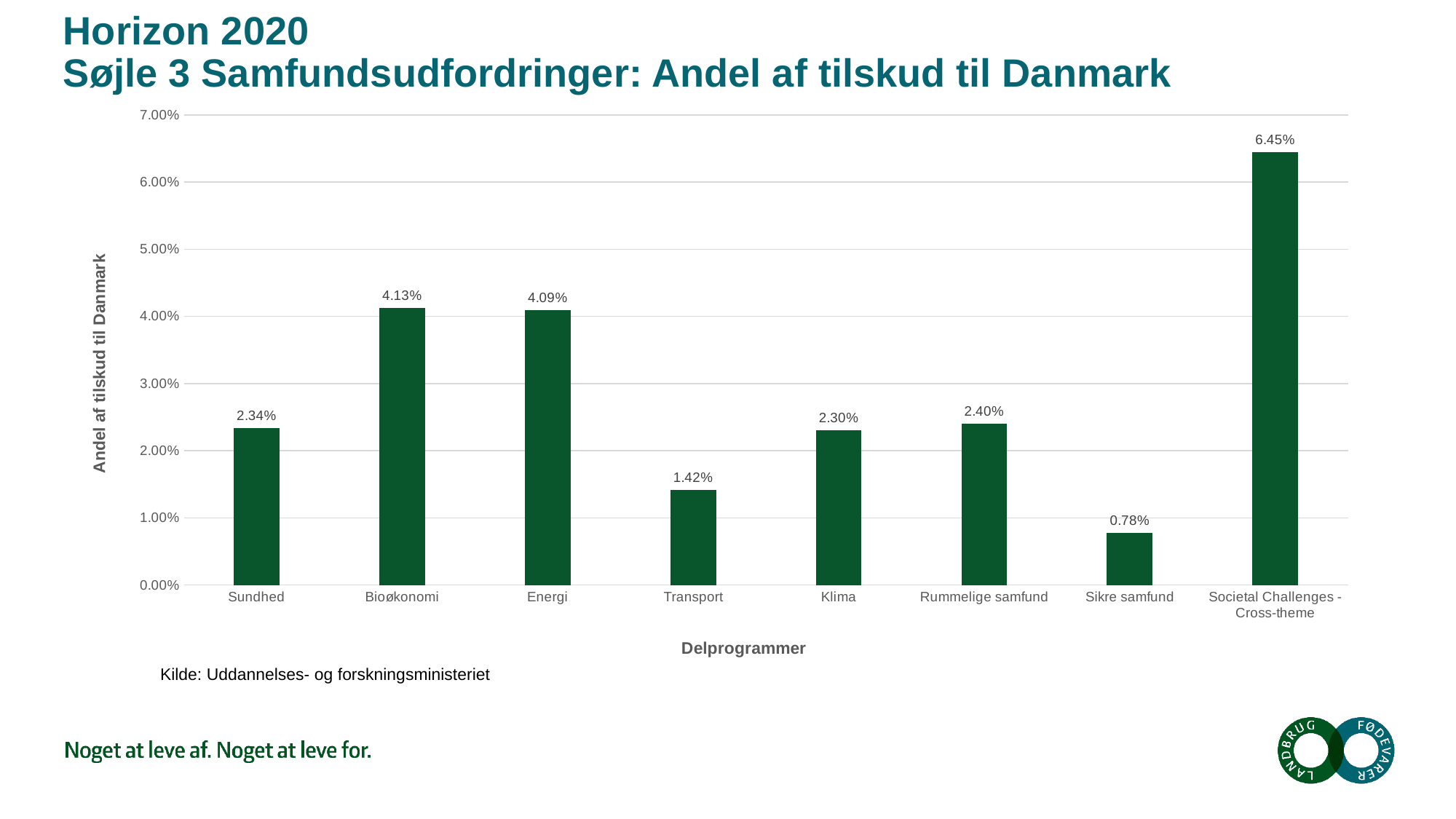
How many categories are shown on the x axis? 8 Is the value for Rummelige samfund greater or less than 2.00%? greater What is the value for Societal Challenges - Cross-theme? 6.45% What is the value for Sundhed? 2.34% Which is larger, the value for Klima or the value for Transport? Klima What is the difference between the values for Societal Challenges - Cross-theme and Sikre samfund? 5.67% What is the difference between the values for Bioøkonomi and Energi? 0.04% What kind of chart is shown on the slide? bar chart Which category has the lowest value? Sikre samfund What is the label of the x axis? Delprogrammer Which category has the highest value? Societal Challenges - Cross-theme What is the value for Transport? 1.42%